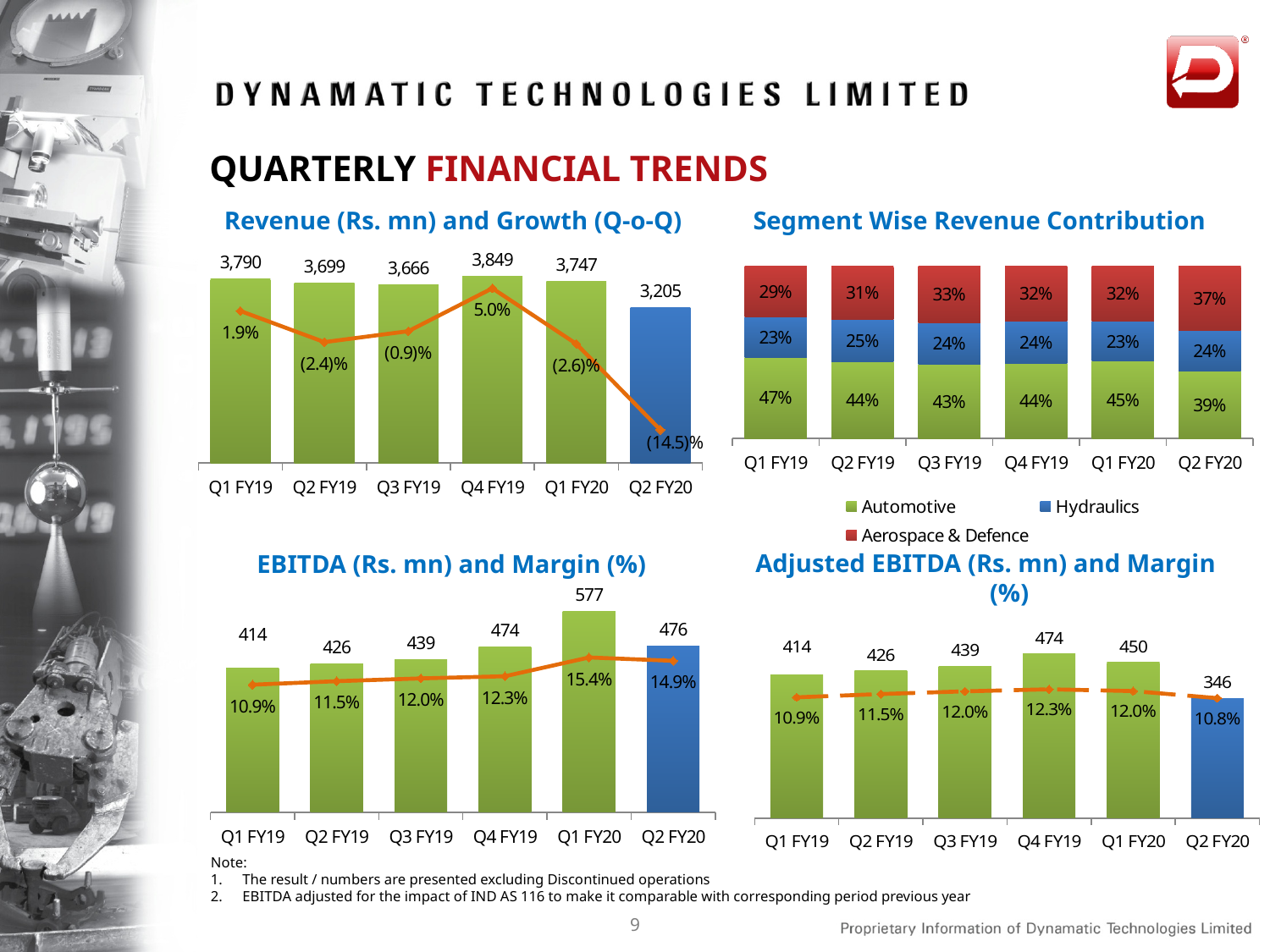
In the 'Revenue (Rs. mn) and Growth (Q-o-Q)' chart, what is the difference in revenue between Q1 FY20 and Q2 FY20? 542 In the 'EBITDA (Rs. mn) and Margin (%)' chart, which quarter has the highest EBITDA? Q1 FY20 In the 'Revenue (Rs. mn) and Growth (Q-o-Q)' chart, what is the revenue for Q4 FY19? 3,849 In the 'Segment Wise Revenue Contribution' chart, what is the Aerospace & Defence share in Q2 FY20? 37% In the 'EBITDA (Rs. mn) and Margin (%)' chart, what is the EBITDA margin for Q1 FY20? 15.4% In the 'Adjusted EBITDA (Rs. mn) and Margin (%)' chart, how many quarters are shown on the x axis? 6 In the 'Revenue (Rs. mn) and Growth (Q-o-Q)' chart, what is the Q-o-Q growth shown for Q2 FY20? (14.5)% In the 'Revenue (Rs. mn) and Growth (Q-o-Q)' chart, which quarter has the lowest revenue? Q2 FY20 What kind of chart is the 'Segment Wise Revenue Contribution' chart? Stacked bar chart In the 'Adjusted EBITDA (Rs. mn) and Margin (%)' chart, what is the adjusted EBITDA for Q2 FY20? 346 In the 'Segment Wise Revenue Contribution' chart, how many series does the legend list? 3 In the 'Segment Wise Revenue Contribution' chart, what is the Automotive share in Q1 FY19? 47%